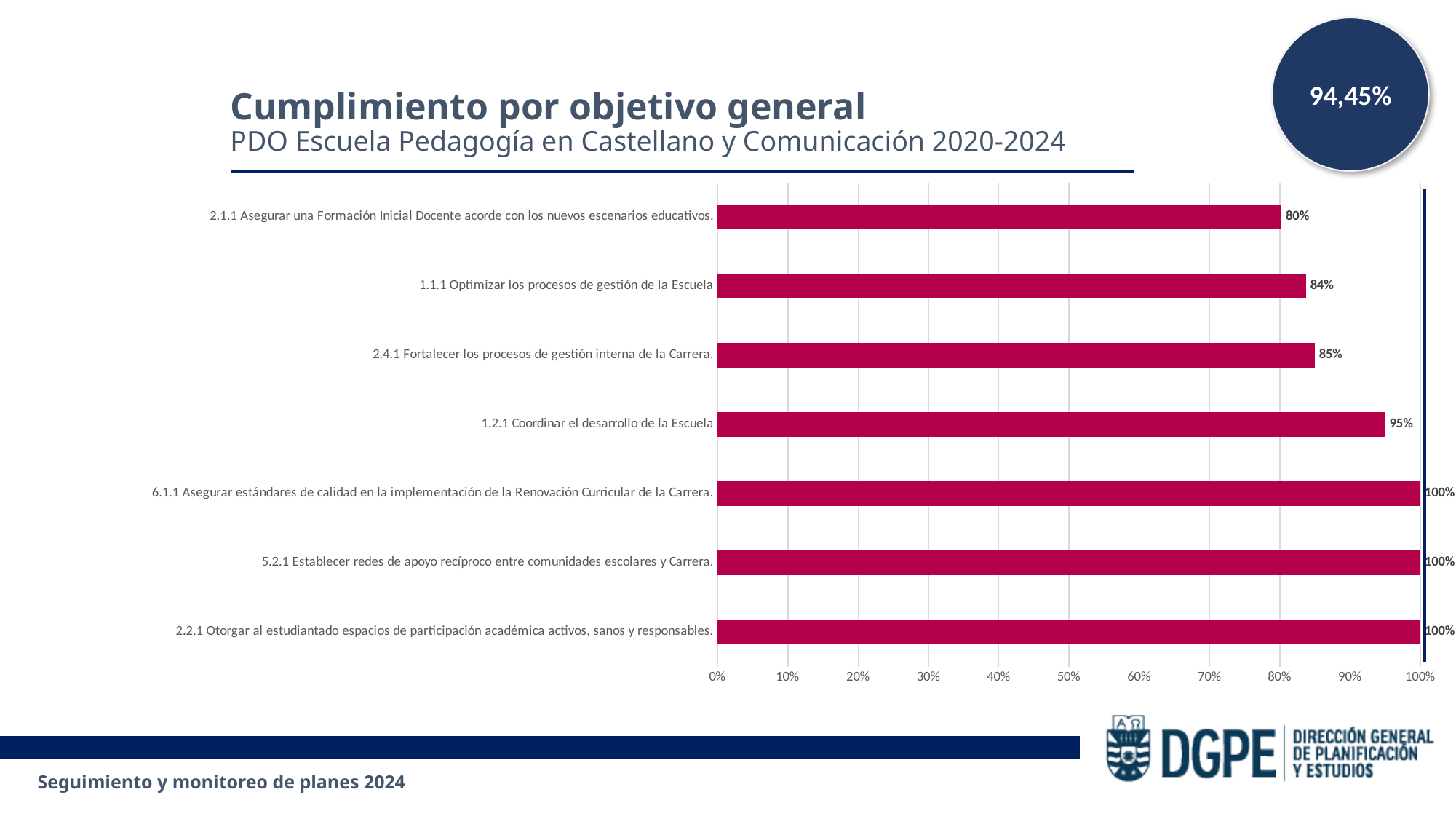
What is the value for objective 1.1.1 Optimizar los procesos de gestión de la Escuela? 84% Which is larger, the value for objective 1.1.1 or the value for objective 1.2.1? 1.2.1 How many objectives are shown on the chart? 7 Which objective has the lowest value on the chart? 2.1.1 Asegurar una Formación Inicial Docente acorde con los nuevos escenarios educativos. What kind of chart is shown on the slide? Bar chart What is the value for objective 2.4.1 Fortalecer los procesos de gestión interna de la Carrera? 85% What is the title of the chart? Cumplimiento por objetivo general How many objectives reach 100%? 3 What overall percentage is shown in the circle at the top right of the slide? 94,45% What is the value for objective 2.1.1 Asegurar una Formación Inicial Docente acorde con los nuevos escenarios educativos? 80% What is the difference between the values for objective 1.2.1 and objective 2.1.1? 15% What is the value for objective 1.2.1 Coordinar el desarrollo de la Escuela? 95%